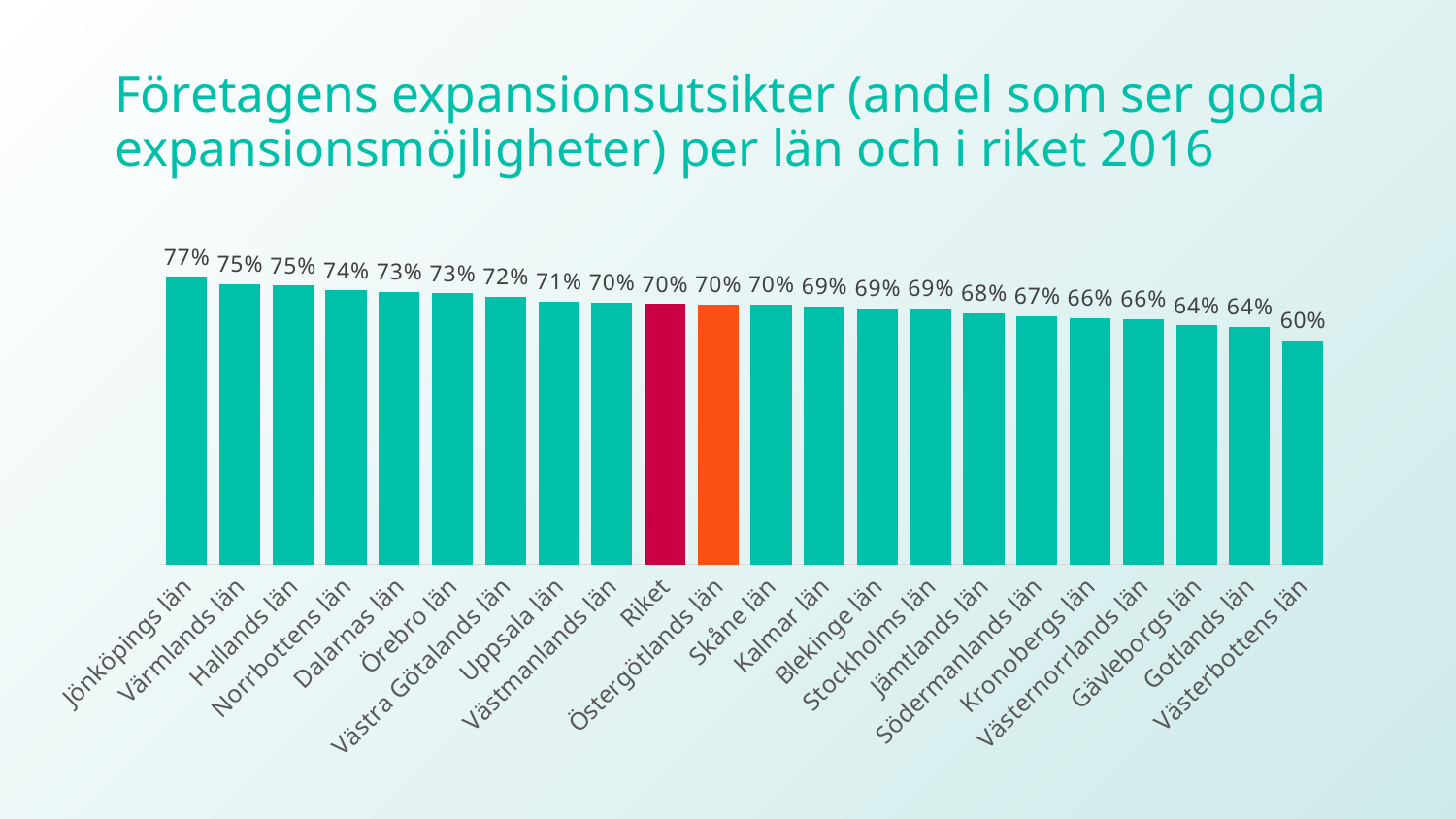
What is the difference between the values for Norrbottens län and Gotlands län? 10% What is the value for Östergötlands län? 70% What kind of chart is shown on the slide? Bar chart What is the value for Riket? 70% Which category has the highest value? Jönköpings län What is the value for Jönköpings län? 77% What is the difference between the values for Jönköpings län and Västerbottens län? 17% Which is larger, the value for Hallands län or the value for Kronobergs län? Hallands län How many bars are shown in the chart? 22 What is the value for Stockholms län? 69% Which category has the lowest value? Västerbottens län Which bar is coloured orange? Östergötlands län